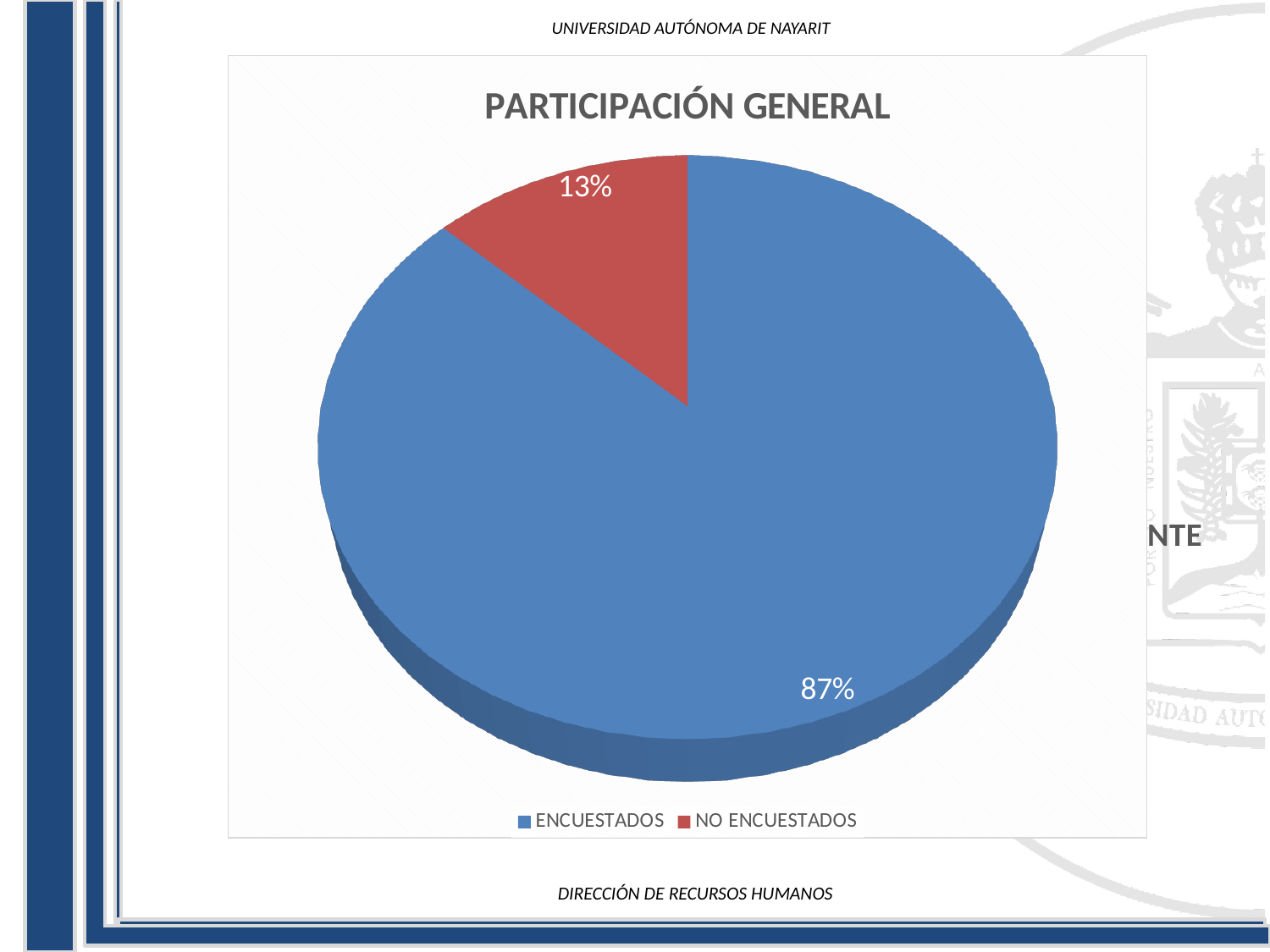
How many categories are shown in the pie chart? 2 What kind of chart is shown on the slide? Pie chart How many entries does the legend list? 2 Which is larger, the ENCUESTADOS slice or the NO ENCUESTADOS slice? ENCUESTADOS Which category has the smallest slice of the pie? NO ENCUESTADOS Which category has the largest slice of the pie? ENCUESTADOS What colour is the NO ENCUESTADOS slice? Red What share of the pie does NO ENCUESTADOS represent? 13% What is the difference in percentage points between ENCUESTADOS and NO ENCUESTADOS? 74 percentage points What share of the pie does ENCUESTADOS represent? 87% What is the title of the chart? PARTICIPACIÓN GENERAL